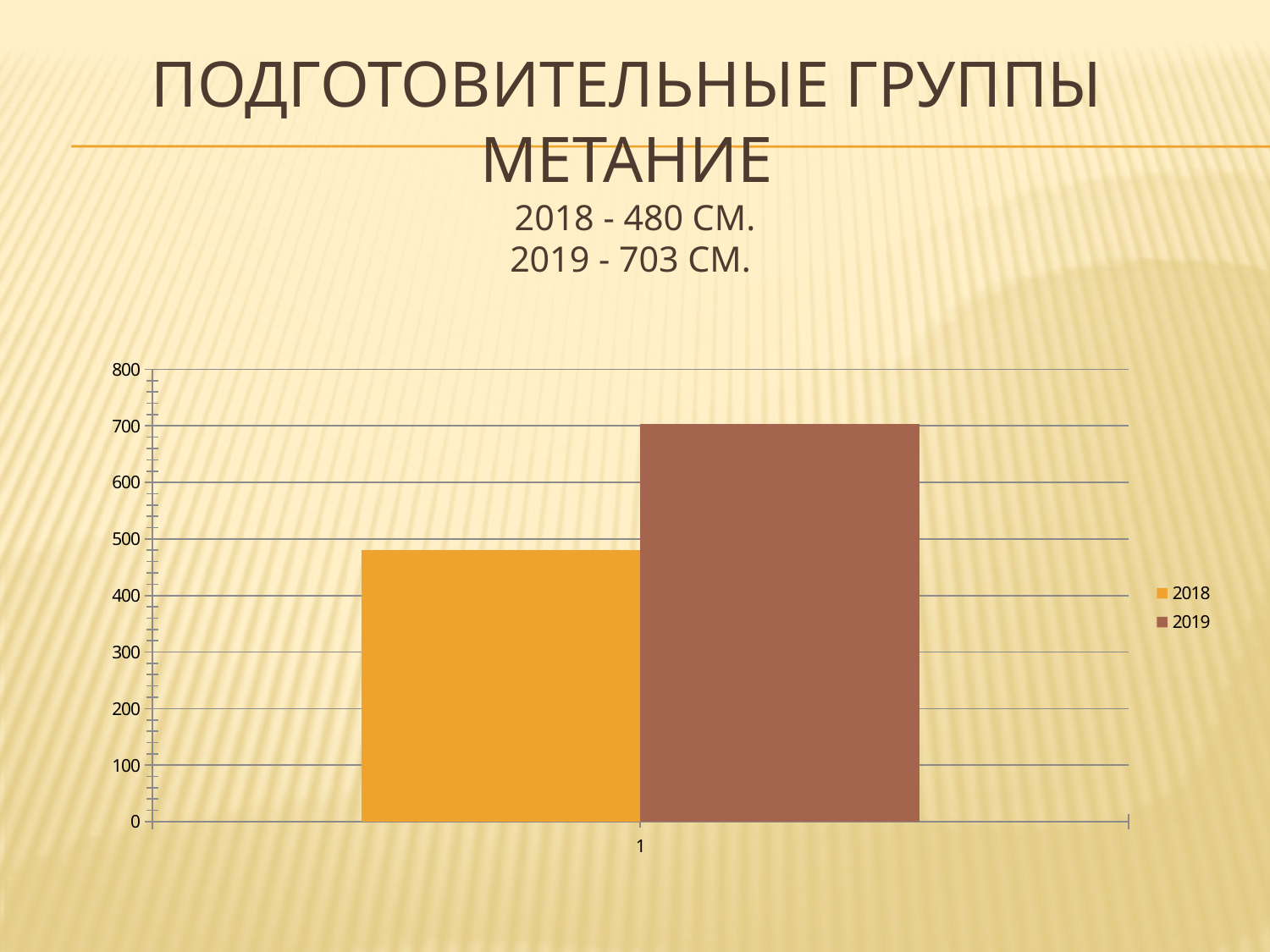
Which series has the taller bar, 2018 or 2019? 2019 What is the value for 2019 according to the slide? 703 см. Which series has the highest value? 2019 What is the difference between the 2019 and 2018 values? 223 How many series does the legend list? 2 What is the highest value shown on the vertical axis? 800 Is the value for 2018 greater or less than 500? less What colour is the bar for 2019? brown Is the value for 2019 greater or less than 700? greater What is the value for 2018 according to the slide? 480 см. What kind of chart is shown on the slide? bar chart Which series has the lowest value? 2018